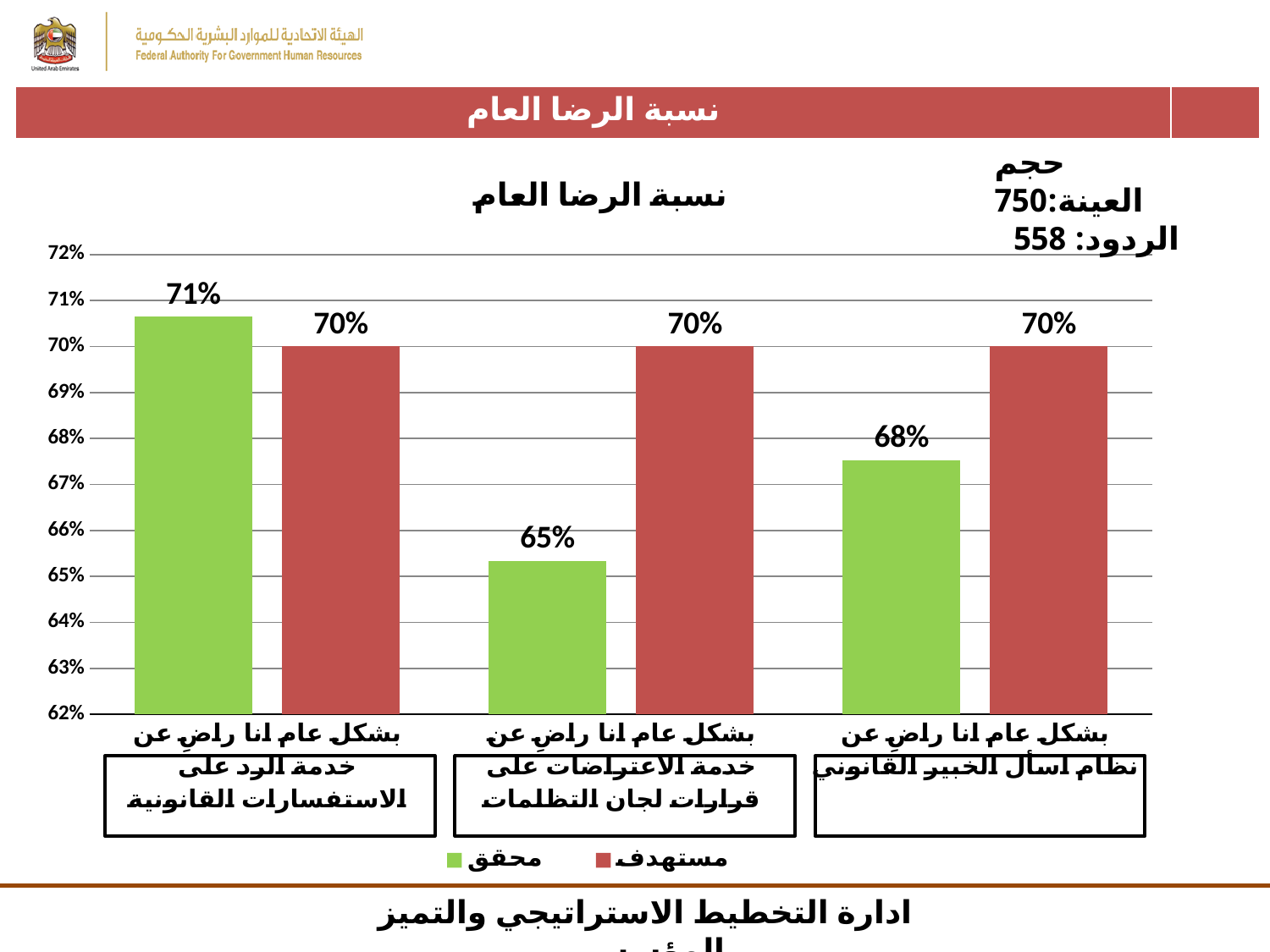
Which category has the lowest achieved (محقق) value? خدمة الاعتراضات على قرارات لجان التظلمات (the middle category) Which category has the highest achieved (محقق) value? خدمة الرد على الاستفسارات القانونية (the leftmost category) What kind of chart is shown on the slide? bar chart What is the target (مستهدف) value for the middle category? 70% What are the two legend entries of the chart? محقق and مستهدف What is the achieved (محقق) value for the first category on the left (خدمة الرد على الاستفسارات القانونية)? 71% How many categories are shown on the x axis of the chart? 3 For the leftmost category, which is larger: the achieved (محقق) value or the target (مستهدف) value? achieved (محقق) What is the achieved (محقق) value for the rightmost category (نظام اسأل الخبير القانوني)? 68% How many series does the chart legend list? 2 What is the achieved (محقق) value for the middle category (خدمة الاعتراضات على قرارات لجان التظلمات)? 65% By how many percentage points does the target exceed the achieved value for the middle category? 5 percentage points